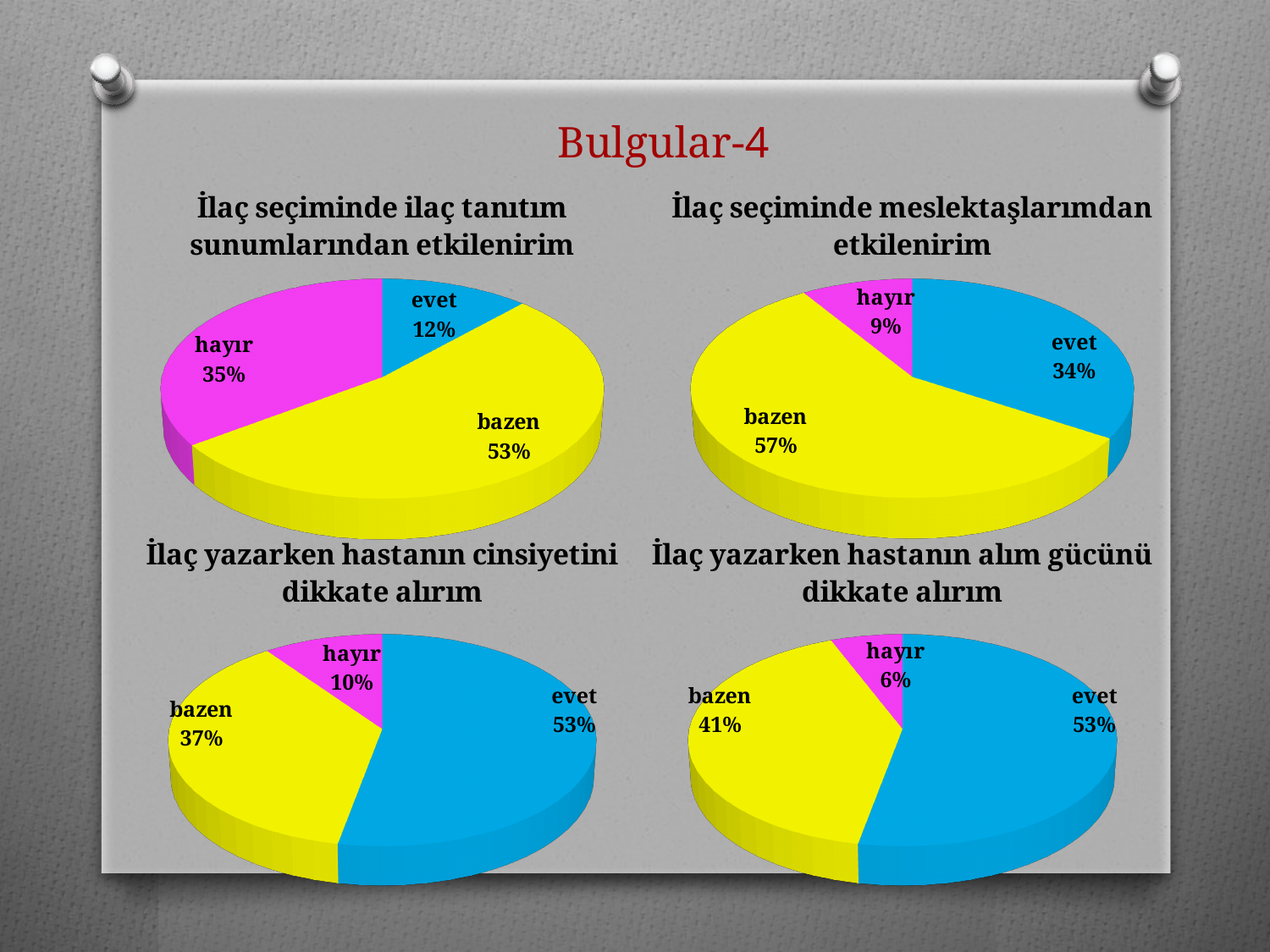
In the bottom-right chart 'İlaç yazarken hastanın alım gücünü dikkate alırım', what is the difference between 'evet' and 'hayır'? 47% In the top-right chart 'İlaç seçiminde meslektaşlarımdan etkilenirim', which category has the largest share? bazen In the top-left chart 'İlaç seçiminde ilaç tanıtım sunumlarından etkilenirim', what is the value for 'bazen'? 53% In the bottom-left chart 'İlaç yazarken hastanın cinsiyetini dikkate alırım', which is larger, 'evet' or 'bazen'? evet What type of chart is the top-left chart 'İlaç seçiminde ilaç tanıtım sunumlarından etkilenirim'? pie chart In the bottom-right chart 'İlaç yazarken hastanın alım gücünü dikkate alırım', what is the value for 'bazen'? 41% In the bottom-left chart 'İlaç yazarken hastanın cinsiyetini dikkate alırım', what is the value for 'hayır'? 10% How many charts are shown on the slide? 4 How many slices does the bottom-right chart 'İlaç yazarken hastanın alım gücünü dikkate alırım' have? 3 In the top-left chart 'İlaç seçiminde ilaç tanıtım sunumlarından etkilenirim', which category has the smallest share? evet In the top-right chart 'İlaç seçiminde meslektaşlarımdan etkilenirim', what is the difference between 'bazen' and 'evet'? 23% In the top-right chart 'İlaç seçiminde meslektaşlarımdan etkilenirim', what is the value for 'evet'? 34%